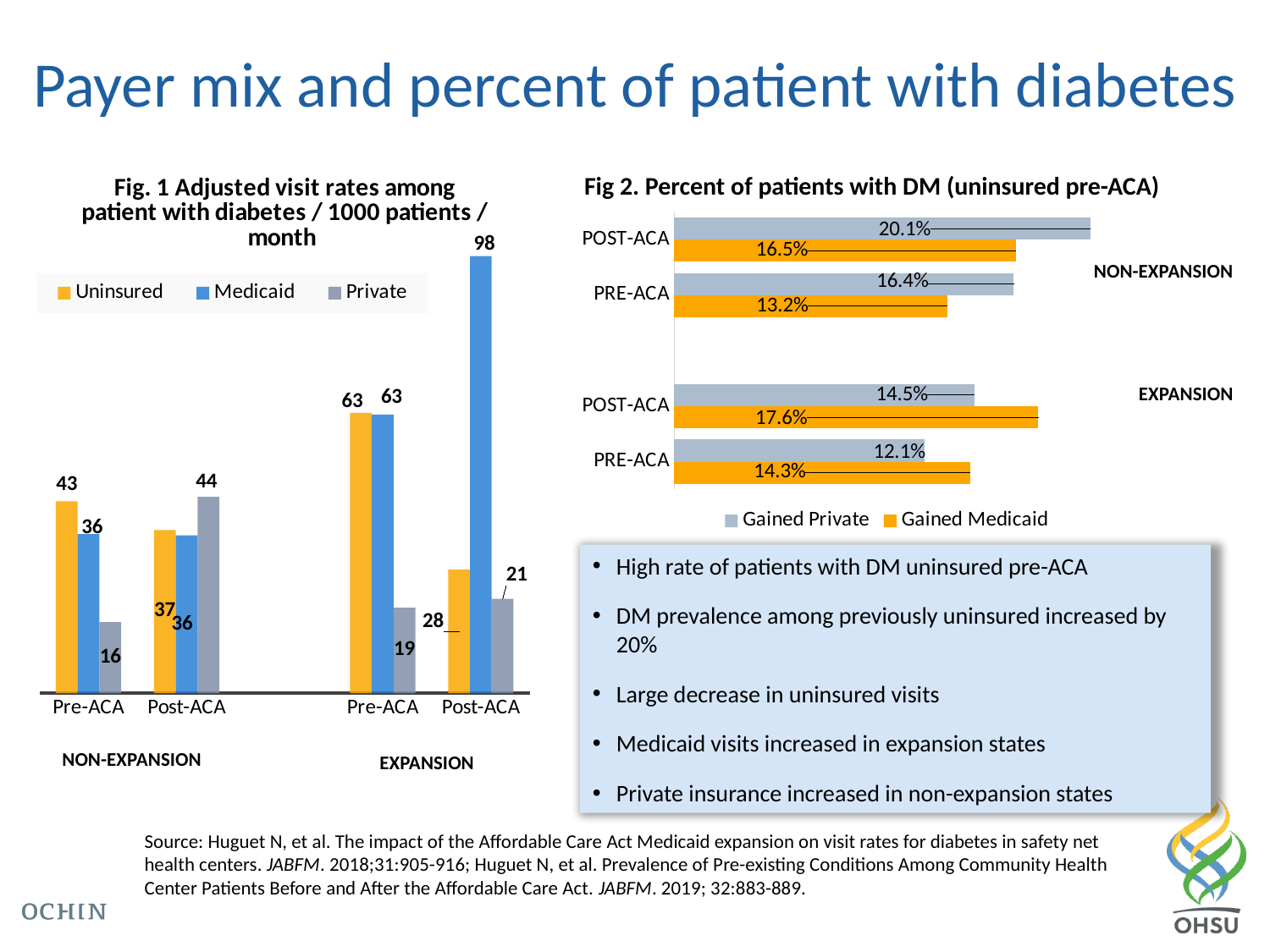
In Fig 2, which colour represents Gained Private? Gray In Fig. 1, what is the difference between the Medicaid visit rate Post-ACA and Pre-ACA in expansion states? 35 In Fig. 1, what is the Uninsured visit rate for Pre-ACA in expansion states? 63 In Fig 2, what is the Gained Medicaid value for Pre-ACA in expansion states? 14.3% In Fig. 1, how many series does the legend list? 3 In Fig. 1, what is the Private visit rate for Pre-ACA in non-expansion states? 16 In Fig. 1, what is the Medicaid visit rate for Post-ACA in expansion states? 98 What kind of chart is Fig. 1? Bar chart In Fig 2, what is the difference between the Gained Medicaid values Post-ACA and Pre-ACA in non-expansion states? 3.3% In Fig 2, what is the Gained Private value for Post-ACA in non-expansion states? 20.1% In Fig 2, which is larger for Post-ACA in expansion states, Gained Private or Gained Medicaid? Gained Medicaid In Fig. 1, which series has the highest value for Post-ACA in non-expansion states? Private